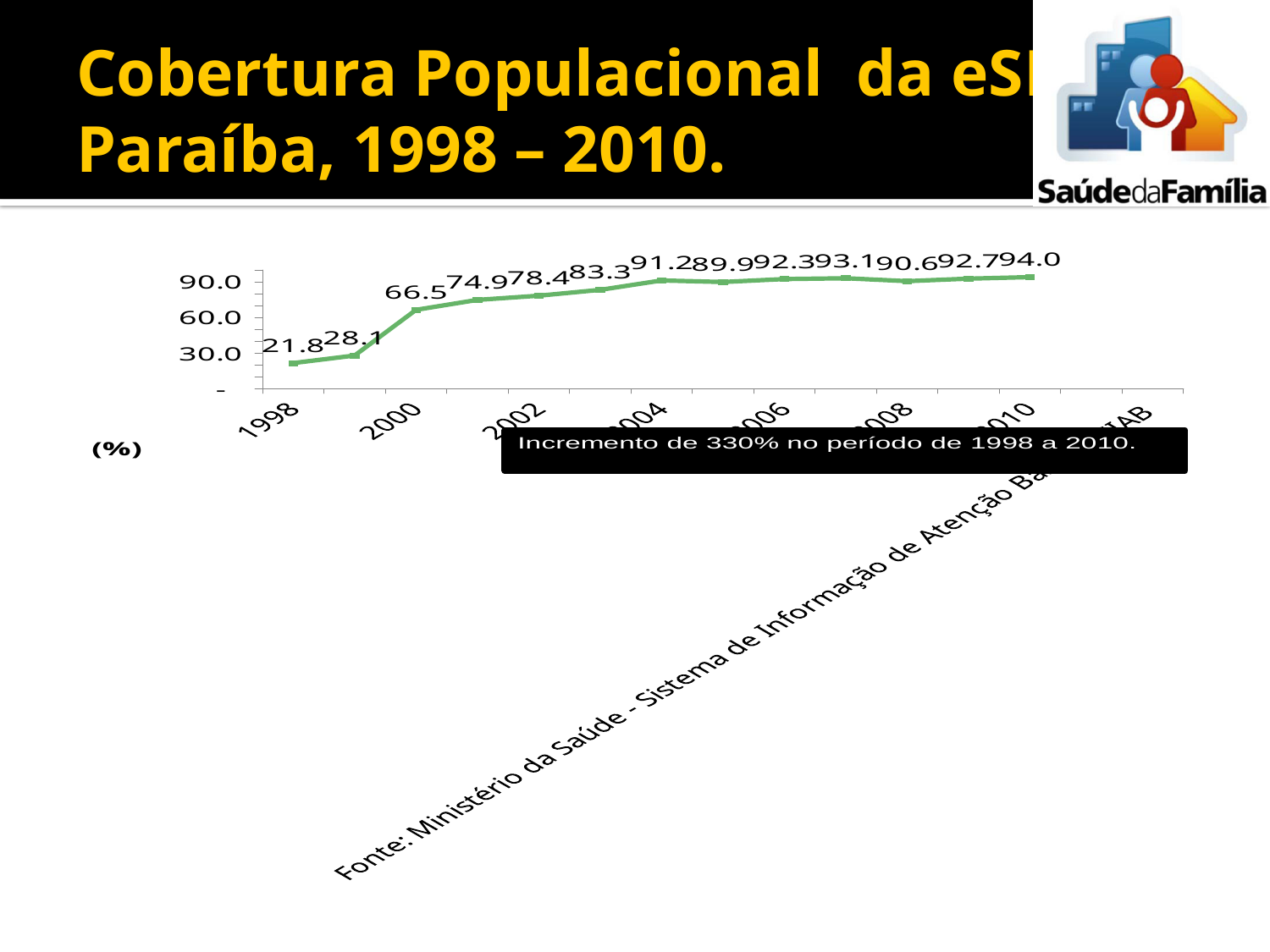
Which year has the highest plotted value? 2010 What is the value plotted for 2002? 78.4 Which year has the lowest plotted value? 1998 What is the value plotted for 2010? 94.0 What is the value plotted for 2000? 66.5 How many data points are plotted on the line? 13 What is the value plotted for 1998? 21.8 Is the value for 1998 greater or less than 30.0? less What is the difference between the values for 2010 and 1998? 72.2 Which is larger, the value for 2000 or the value for 2002? 2002 Do the values generally rise or fall from 1998 to 2010? rise What type of chart is shown on the slide? line chart